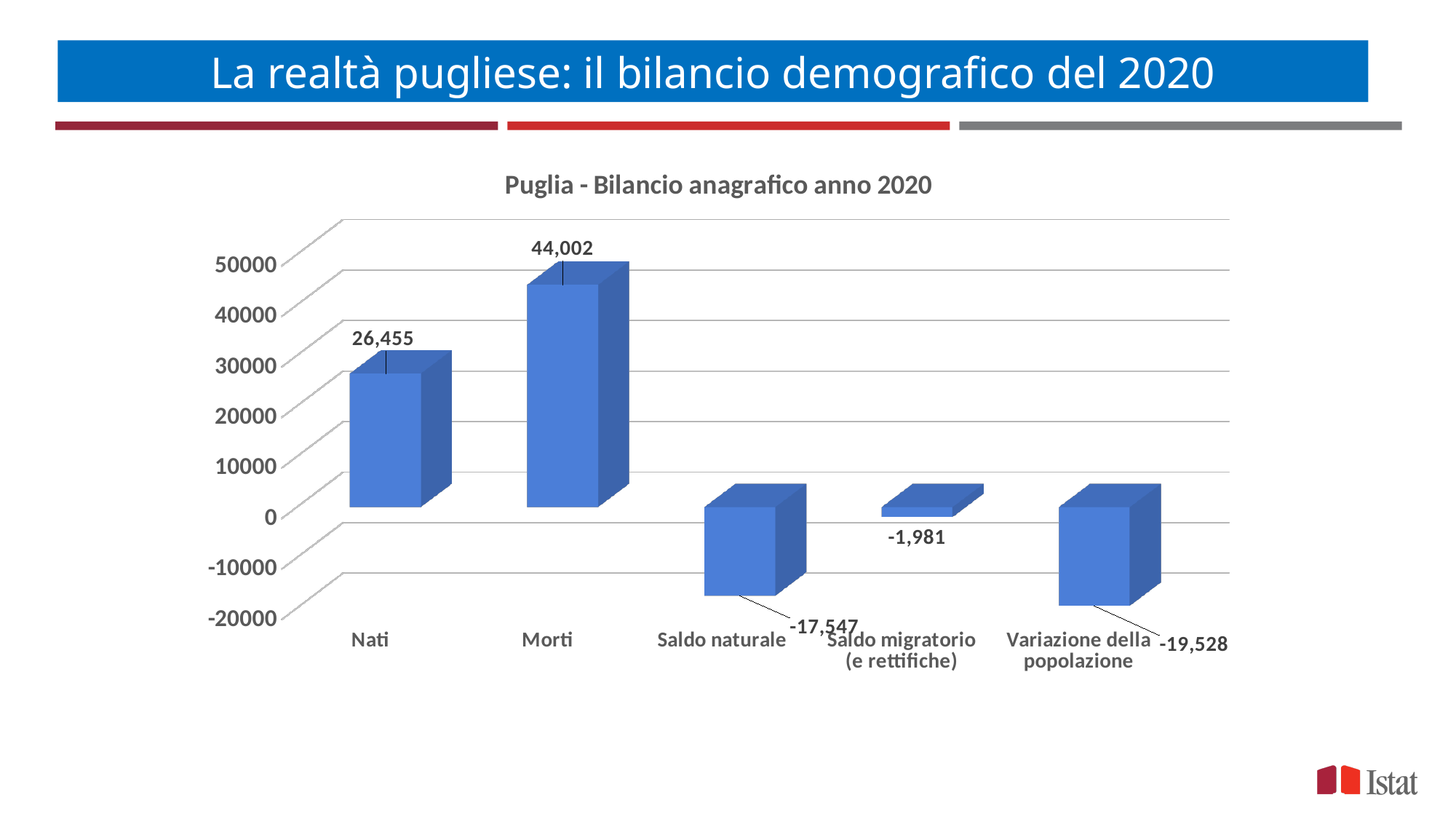
What is the value for Variazione della popolazione? -19,528 What kind of chart is shown on the slide? Bar chart What is the difference between Morti and Nati? 17,547 What is the value for Saldo naturale? -17,547 What is the value for Morti? 44,002 What is the value for Nati? 26,455 What is the value for Saldo migratorio (e rettifiche)? -1,981 How many categories are shown on the x axis? 5 Which is larger, the value for Nati or the value for Morti? Morti What is the title of the chart? Puglia - Bilancio anagrafico anno 2020 Which category has the highest value? Morti Which category has the lowest value? Variazione della popolazione